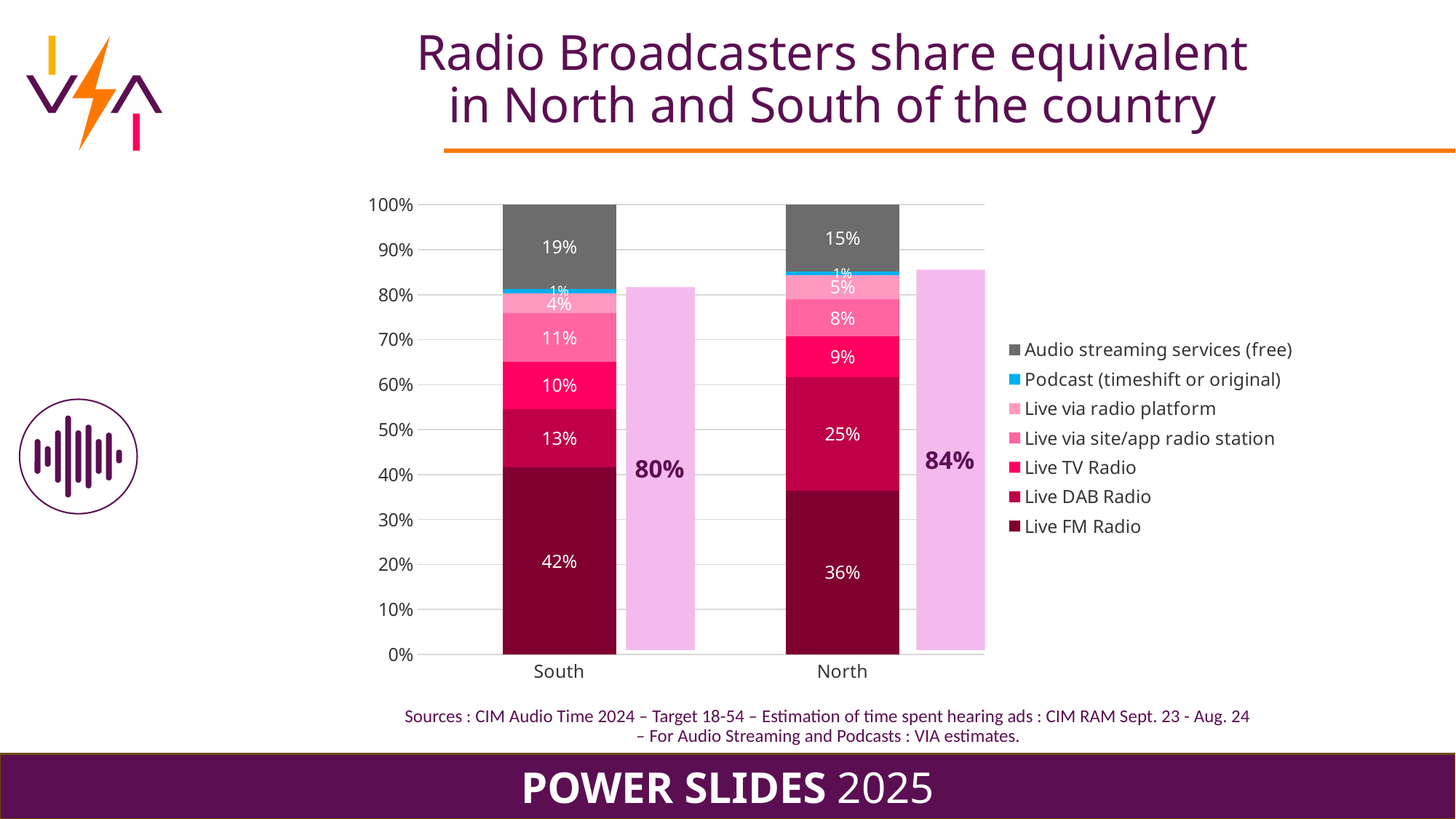
Which region has the larger value for Live DAB Radio, South or North? North What is the difference between the Live FM Radio values for South and North? 6 percentage points What is the value for Audio streaming services (free) in the South bar? 19% What kind of chart is shown on the slide? Stacked bar chart What is the value for Live via site/app radio station in the North bar? 8% What is the radio broadcasters share equivalent shown for the North? 84% What is the value for Podcast (timeshift or original) in the South bar? 1% How many regions are shown on the x axis? 2 What is the value for Live DAB Radio in the North bar? 25% How many series does the legend list? 7 What is the value for Live FM Radio in the South bar? 42% Which series has the largest segment in the South bar? Live FM Radio